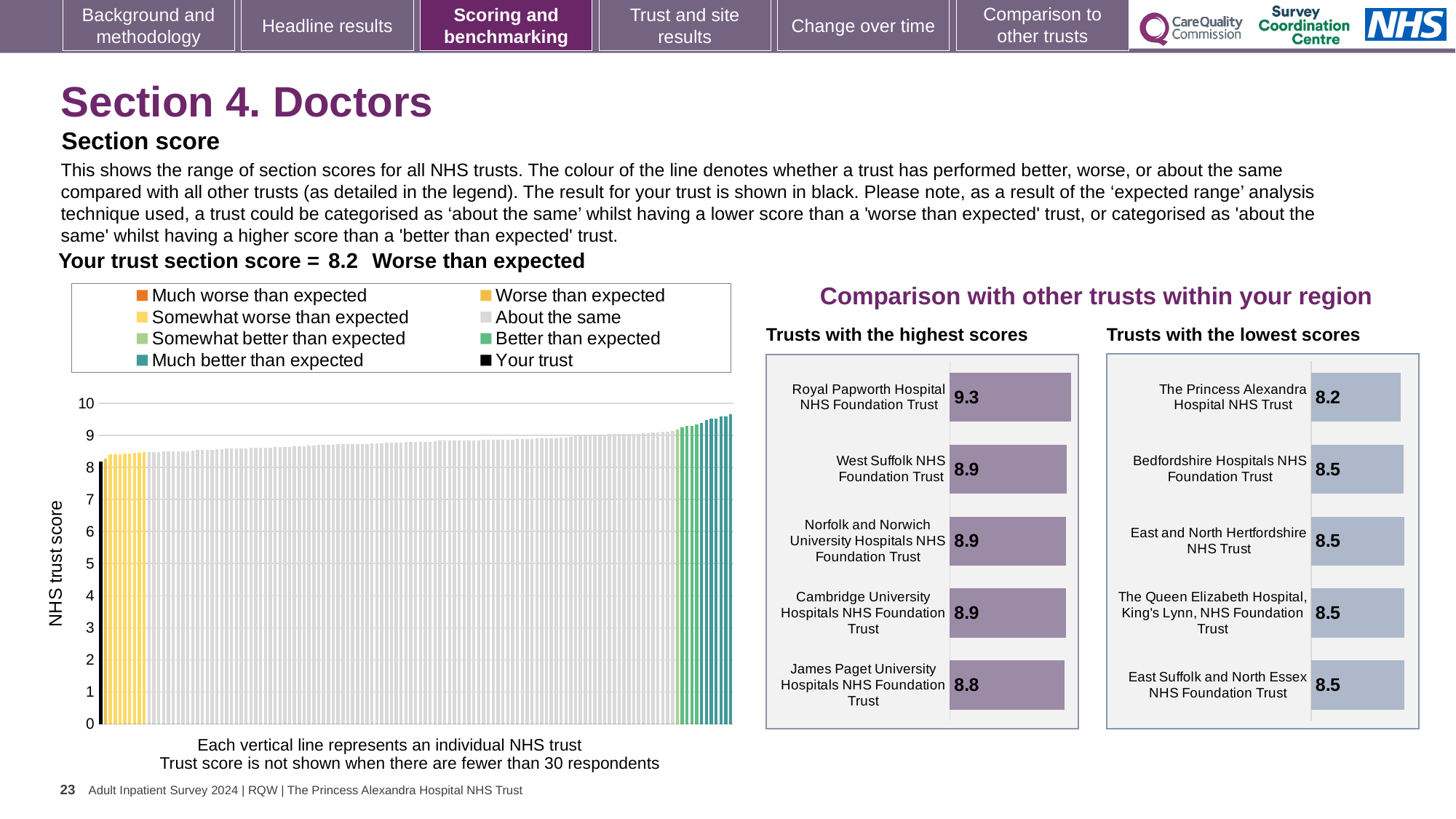
In the 'Trusts with the highest scores' chart, what is the difference between the scores of Royal Papworth Hospital NHS Foundation Trust and James Paget University Hospitals NHS Foundation Trust? 0.5 In the 'Trusts with the lowest scores' chart, what is the score for East Suffolk and North Essex NHS Foundation Trust? 8.5 In the large chart on the left showing all NHS trusts, what is the section score for your trust (the black bar)? 8.2 In the 'Trusts with the highest scores' chart, which trust has the lowest score? James Paget University Hospitals NHS Foundation Trust In the 'Trusts with the highest scores' chart, how many trusts are shown? 5 In the 'Trusts with the highest scores' chart, what is the score for Royal Papworth Hospital NHS Foundation Trust? 9.3 In the large chart on the left showing all NHS trusts, how many entries does the legend list? 8 Which is larger: the score for Royal Papworth Hospital NHS Foundation Trust in the 'Trusts with the highest scores' chart or the score for The Princess Alexandra Hospital NHS Trust in the 'Trusts with the lowest scores' chart? Royal Papworth Hospital NHS Foundation Trust In the 'Trusts with the lowest scores' chart, what is the difference between the scores of Bedfordshire Hospitals NHS Foundation Trust and The Princess Alexandra Hospital NHS Trust? 0.3 In the 'Trusts with the lowest scores' chart, what is the score for The Princess Alexandra Hospital NHS Trust? 8.2 In the 'Trusts with the lowest scores' chart, which trust has the lowest score? The Princess Alexandra Hospital NHS Trust What type of chart is the large chart on the left showing all NHS trusts? Bar chart